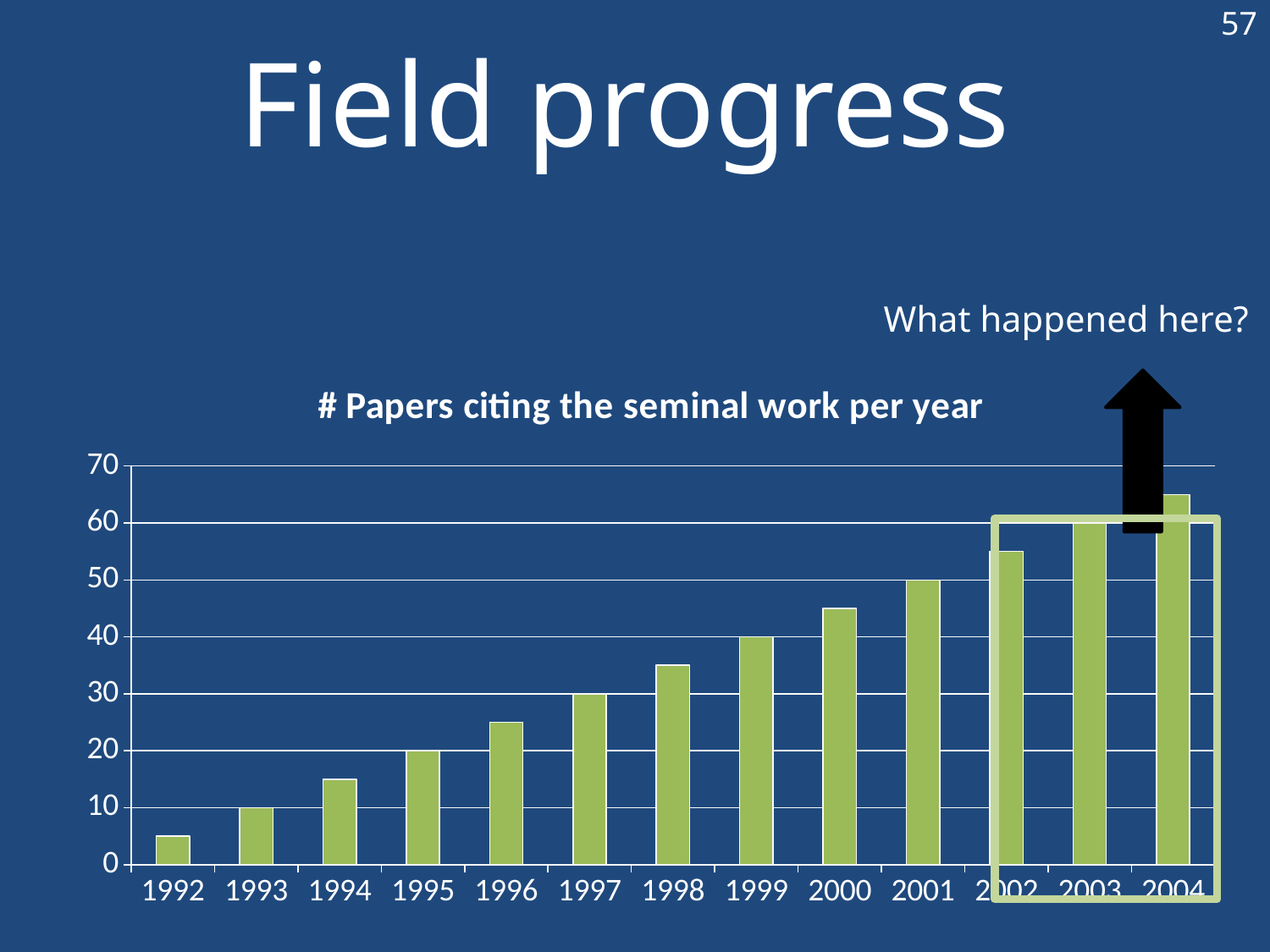
Which year has the lowest number of papers citing the seminal work? 1992 What is the value for 1995? 20 What kind of chart is shown on the slide? bar chart What is the value for 2003? 60 Do the values rise or fall from 1992 to 2004? rise What is the title of the chart? # Papers citing the seminal work per year Is the value for 2004 greater or less than 60? greater Which year has a larger value, 1998 or 2000? 2000 What is the value for 1999? 40 How many years are shown on the x axis of the chart? 13 Which year has the highest number of papers citing the seminal work? 2004 Is the value for 1996 greater or less than 30? less